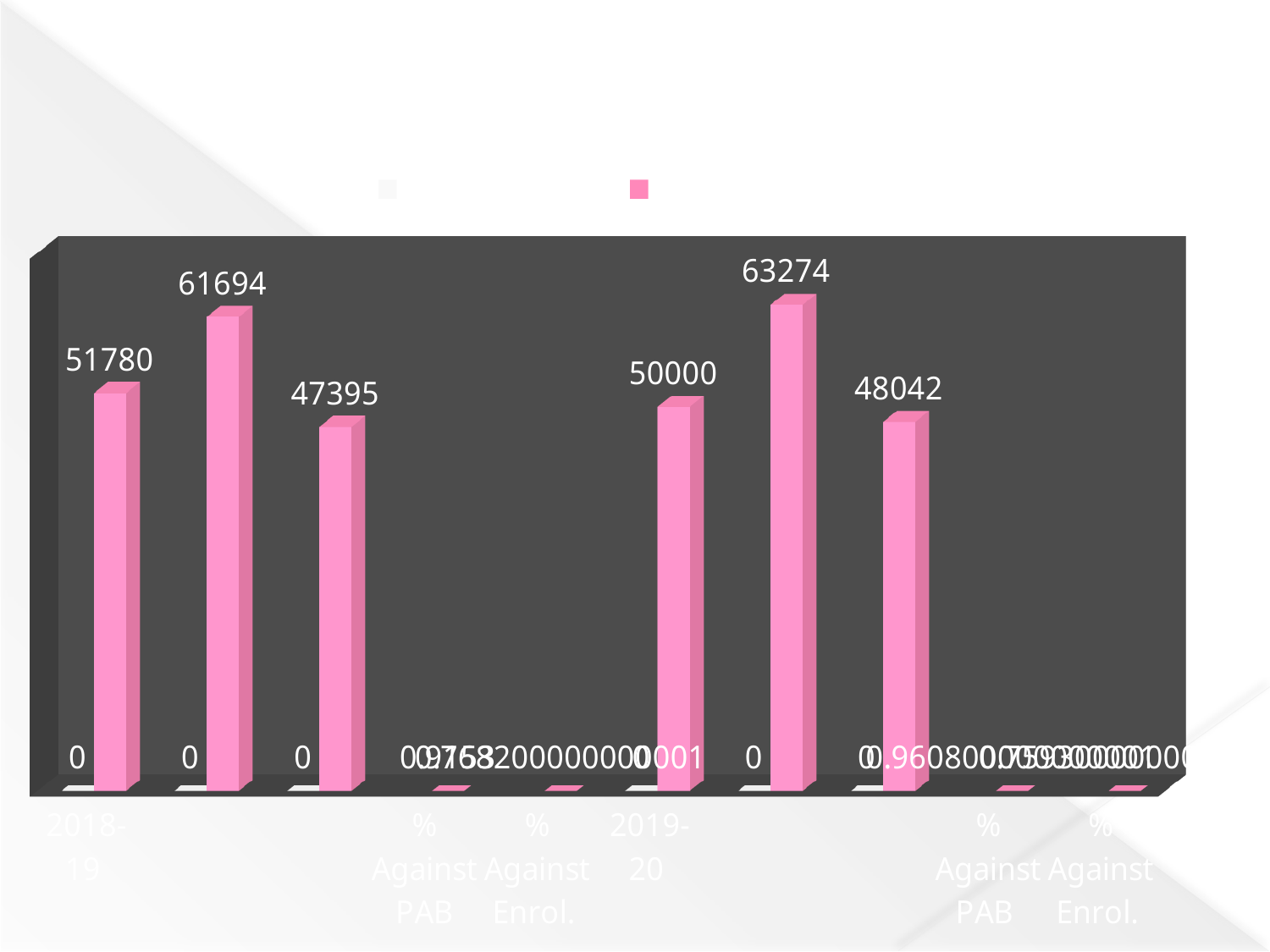
How many entries does the legend show? 2 What is the difference between the tallest bar (63274) and the second-tallest bar (61694)? 1580 How many category positions are there along the x axis? 10 What is the difference between the 2018-19 bar (51780) and the 2019-20 bar (50000)? 1780 What kind of chart is shown on the slide? Bar chart What is the value of the bar for 2019-20? 50000 What is the value shown on the tallest bar in the chart? 63274 What is the difference between the tallest bar (63274) and the 2019-20 bar (50000)? 13274 What is the value of the bar for 2018-19? 51780 What is the value shown on the second-tallest bar in the chart? 61694 Which bar is taller, 2018-19 or 2019-20? 2018-19 What colour are the bars in the chart? Pink